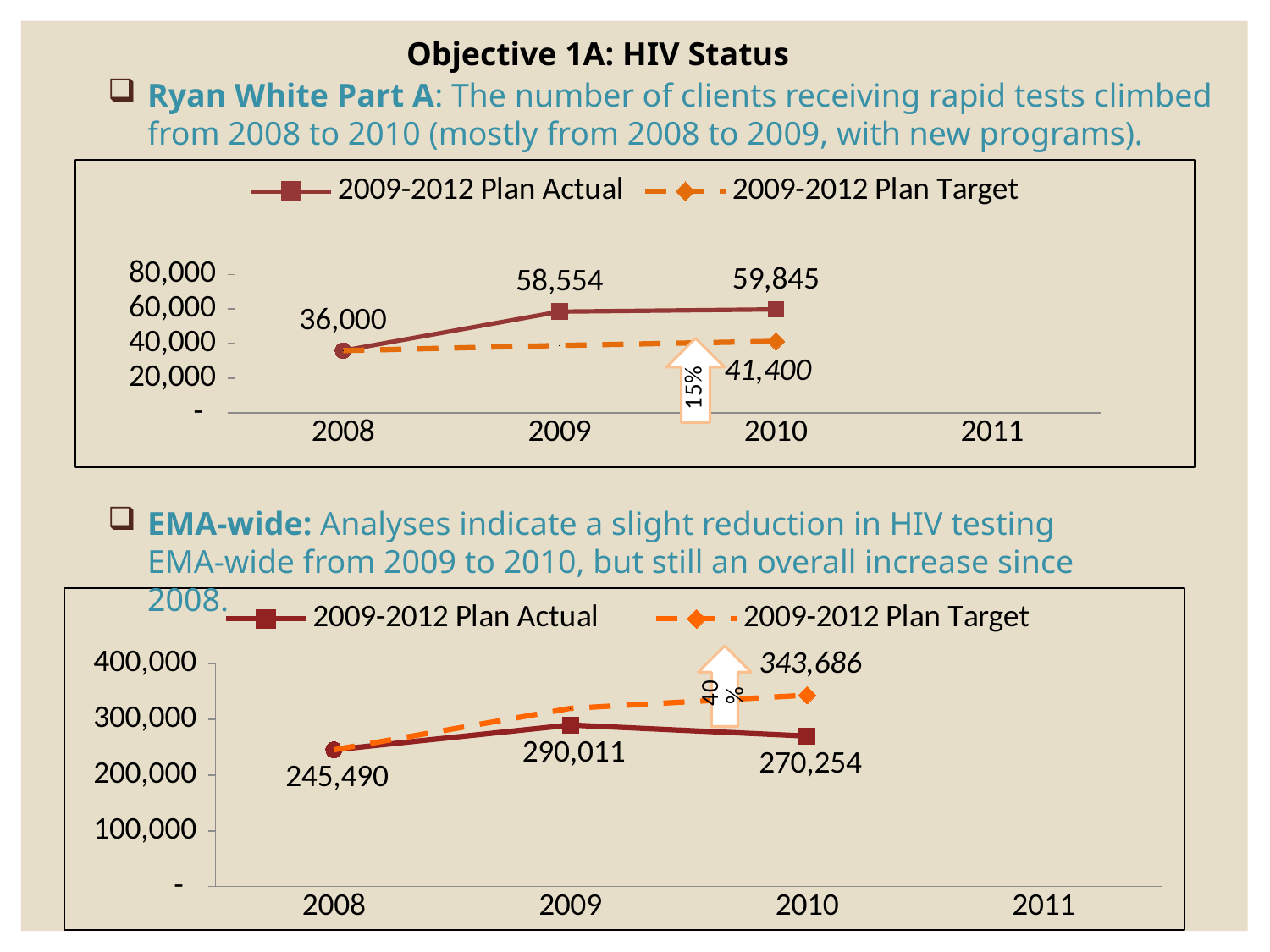
In the top chart, what is the difference between the 2009-2012 Plan Actual values for 2009 and 2008? 22,554 In the bottom chart, what is the 2009-2012 Plan Actual value for 2009? 290,011 In the top chart, what is the 2009-2012 Plan Actual value for 2010? 59,845 In the bottom chart, what is the 2009-2012 Plan Target value for 2010? 343,686 What kind of chart is the bottom chart? line chart In the top chart, which is larger for 2010: the 2009-2012 Plan Actual or the 2009-2012 Plan Target? 2009-2012 Plan Actual In the bottom chart, what is the difference between the 2009-2012 Plan Target and the 2009-2012 Plan Actual for 2010? 73,432 In the bottom chart, in which year is the 2009-2012 Plan Actual value highest? 2009 In the top chart, what is the 2009-2012 Plan Actual value for 2009? 58,554 In the top chart, what is the 2009-2012 Plan Actual value for 2008? 36,000 In the top chart, how many series does the legend list? 2 In the top chart, what is the 2009-2012 Plan Target value for 2010? 41,400